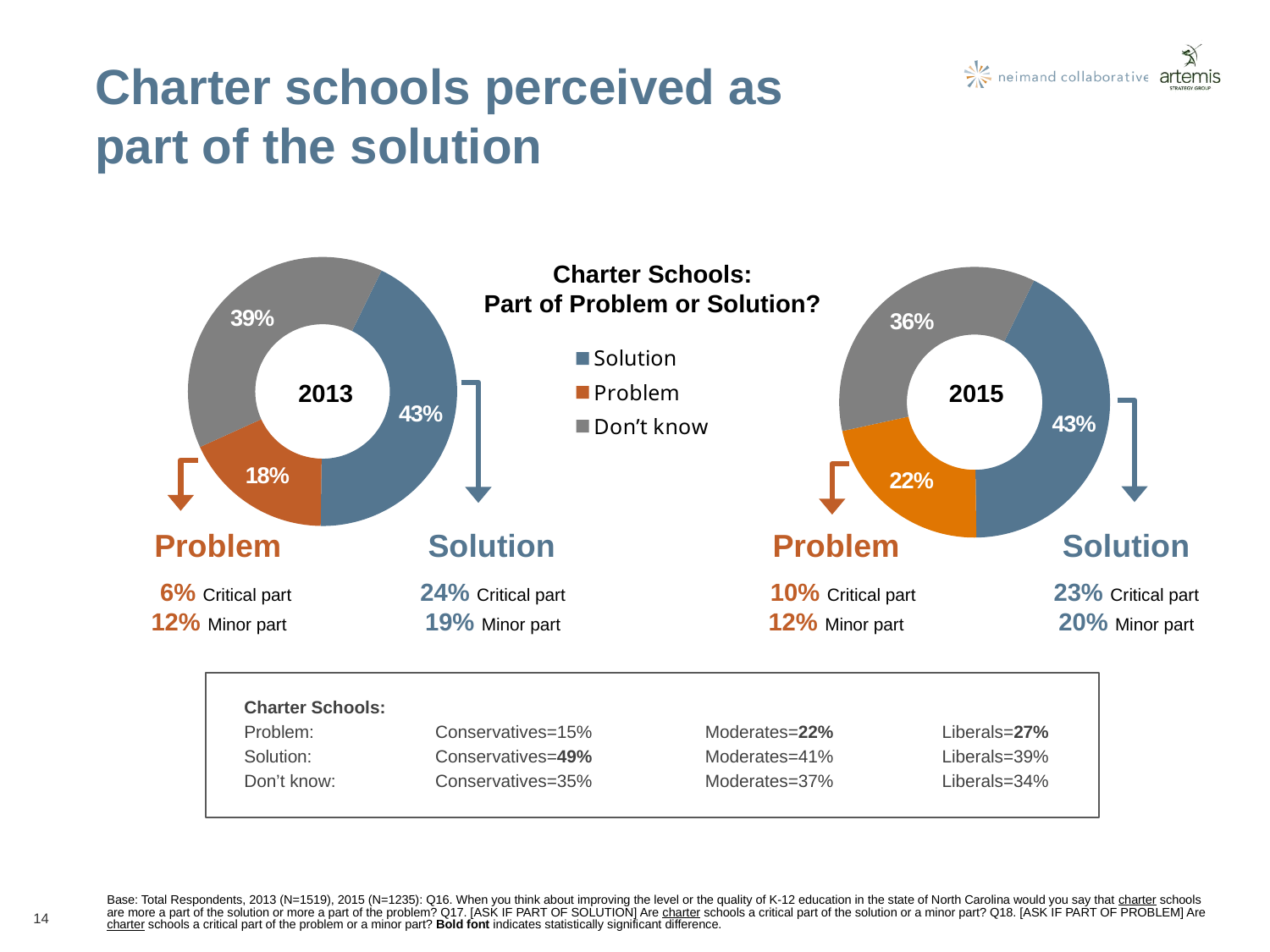
How many categories does each donut chart show? 3 In the 2015 donut chart, what percentage is shown for Problem? 22% How many entries does the shared legend list? 3 In the 2013 donut chart, what is the difference between the Solution share and the Don't know share? 4% In the 2015 donut chart, what percentage is shown for Don't know? 36% In the 2015 donut chart, which category has the smallest share? Problem In the 2013 donut chart, what percentage is shown for Problem? 18% In the 2013 donut chart, which category has the largest share? Solution In the 2013 donut chart, what percentage is shown for Solution? 43% What is the difference between the Problem share in 2015 and the Problem share in 2013? 4% Which is larger in the 2015 donut chart: the Solution share or the Don't know share? Solution What type of chart is used to show the 2013 and 2015 data? Donut (pie) chart